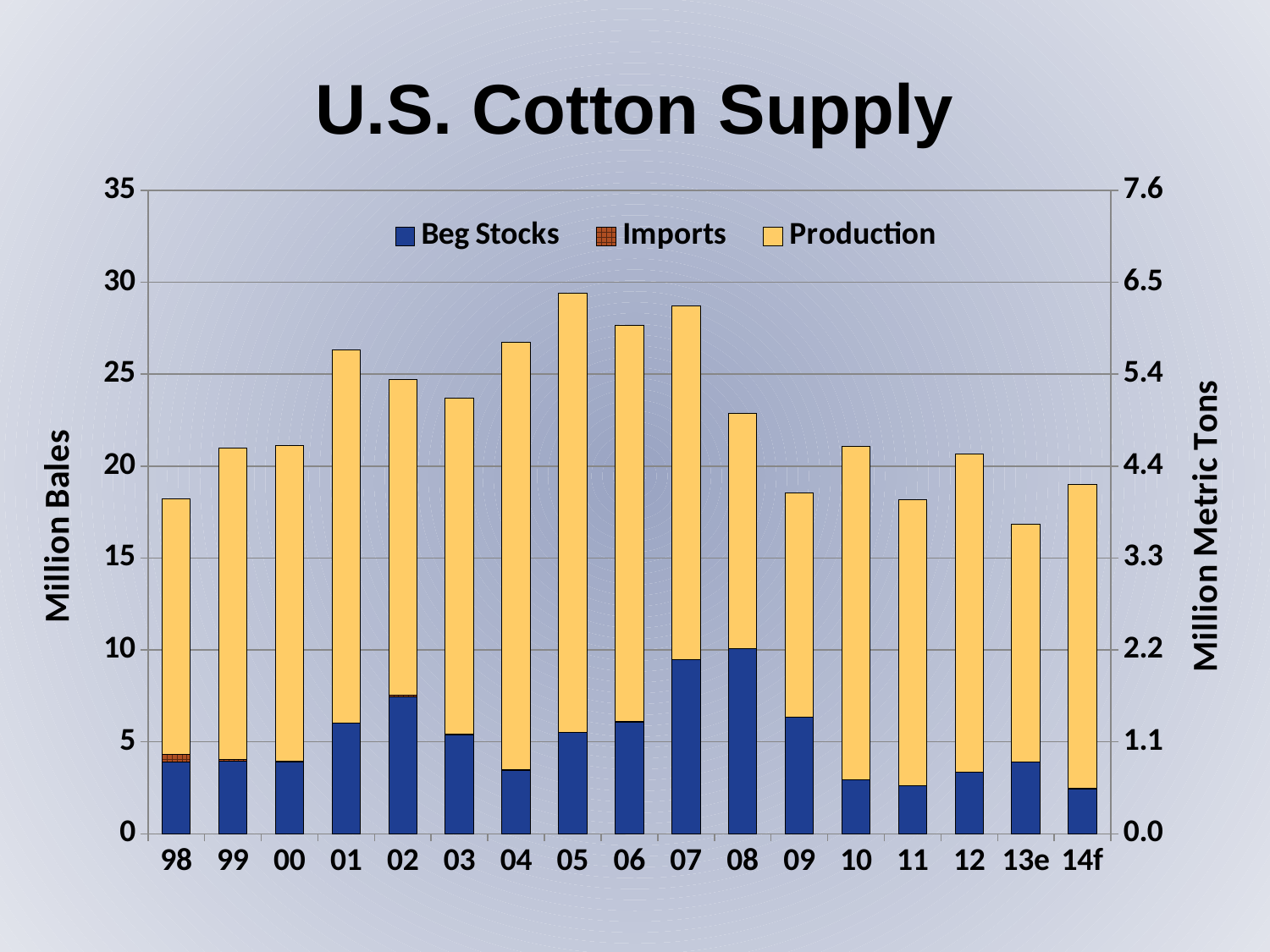
What kind of chart is shown on the slide? Stacked bar chart Is the total stacked bar for 05 greater or less than 25 million bales? greater What is the label on the right-hand vertical axis? Million Metric Tons Is the total stacked bar for 13e greater or less than 20 million bales? less Is the Beg Stocks value for 02 greater or less than 5 million bales? greater Do the total stacked bars rise or fall from 98 to 01? rise Which year has the larger total stacked bar, 01 or 02? 01 Which year has the shortest stacked bar (smallest total supply)? 13e Which year has the largest Beg Stocks segment? 08 How many years (categories) are shown on the x axis? 17 Which year has the tallest stacked bar (largest total supply)? 05 How many series does the legend list? 3